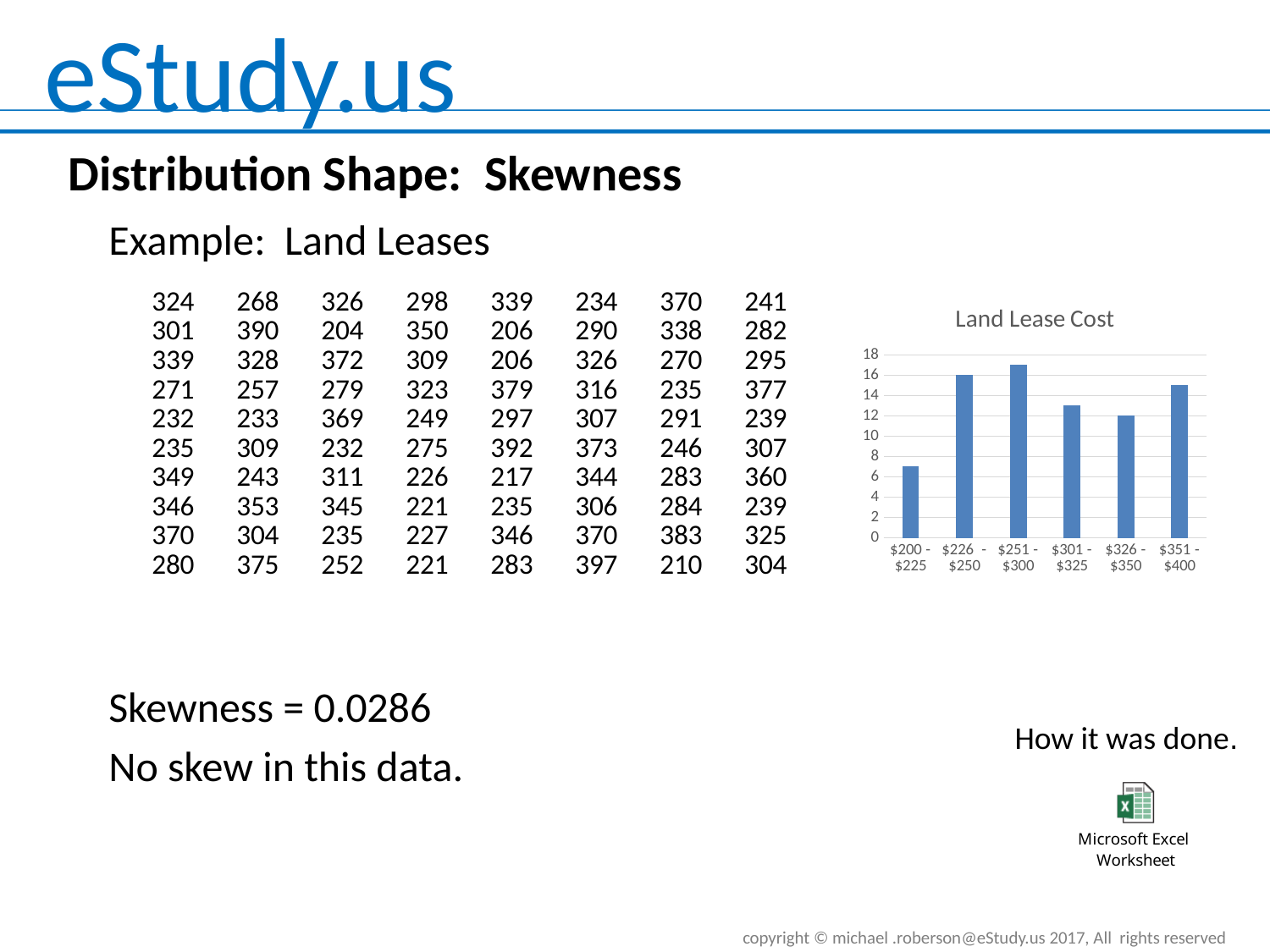
What is the title of the chart? Land Lease Cost Which is larger, the value for $226 - $250 or the value for $326 - $350? $226 - $250 What is the highest value shown on the vertical axis of the chart? 18 Which category has the lowest bar in the Land Lease Cost chart? $200 - $225 What kind of chart is shown on the slide? bar chart Is the value for $351 - $400 greater or less than 14? greater Is the value for $301 - $325 greater or less than 14? less Is the value for $251 - $300 greater or less than 16? greater Which category has the highest bar in the Land Lease Cost chart? $251 - $300 How many categories (bars) does the Land Lease Cost chart show? 6 Which is larger, the value for $200 - $225 or the value for $301 - $325? $301 - $325